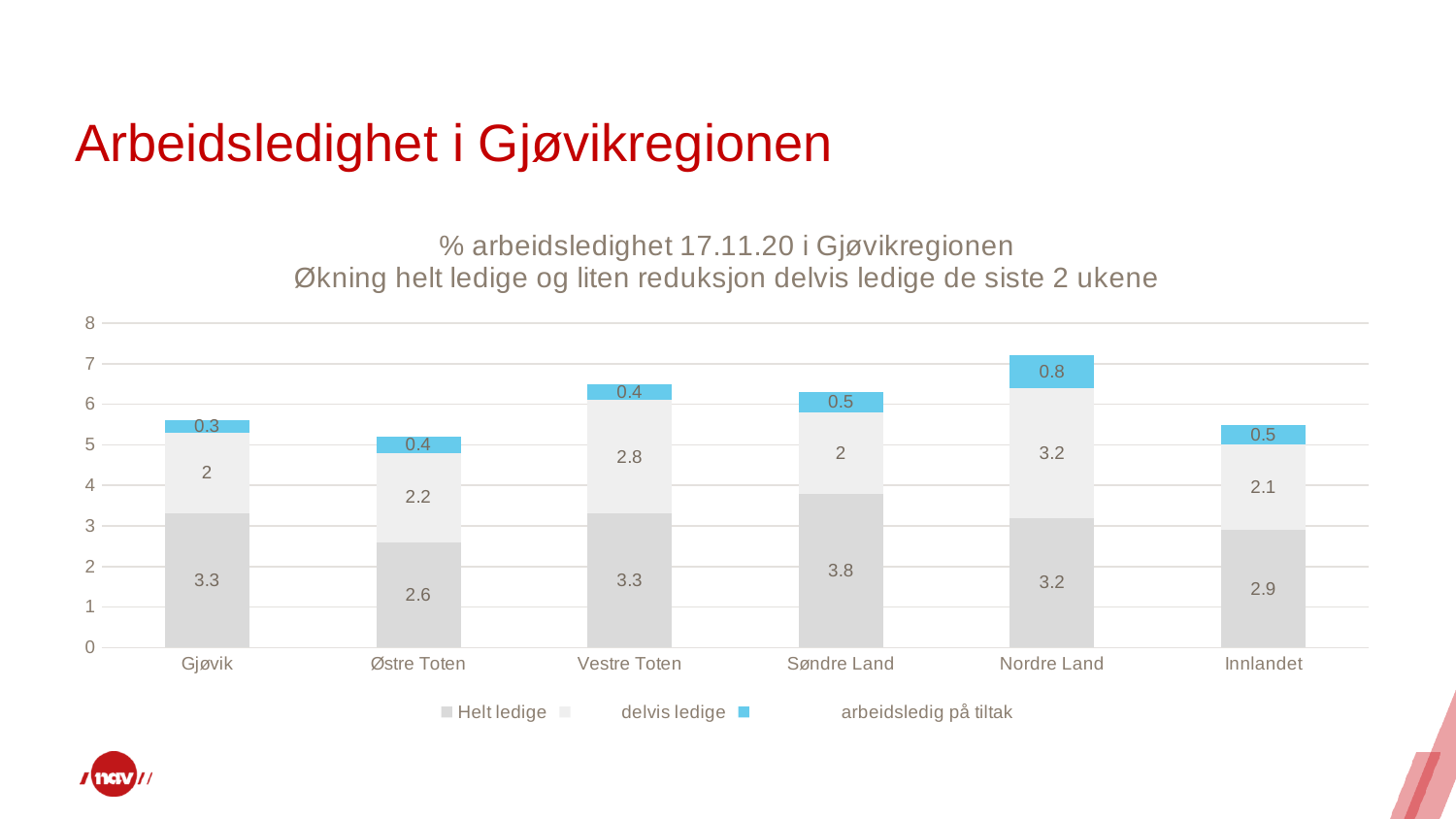
Which is larger, the delvis ledige value for Nordre Land or for Innlandet? Nordre Land What kind of chart is shown on the slide? Stacked bar chart How many categories are shown on the x axis? 6 Which category has the lowest arbeidsledig på tiltak value? Gjøvik What is the total of the stacked bar for Nordre Land? 7.2 Which category has the highest Helt ledige value? Søndre Land What is the value of Helt ledige for Søndre Land? 3.8 What is the value of delvis ledige for Vestre Toten? 2.8 How many series does the legend list? 3 What is the value of arbeidsledig på tiltak for Nordre Land? 0.8 What is the total of the stacked bar for Gjøvik? 5.6 What is the difference between the Helt ledige values for Søndre Land and Østre Toten? 1.2